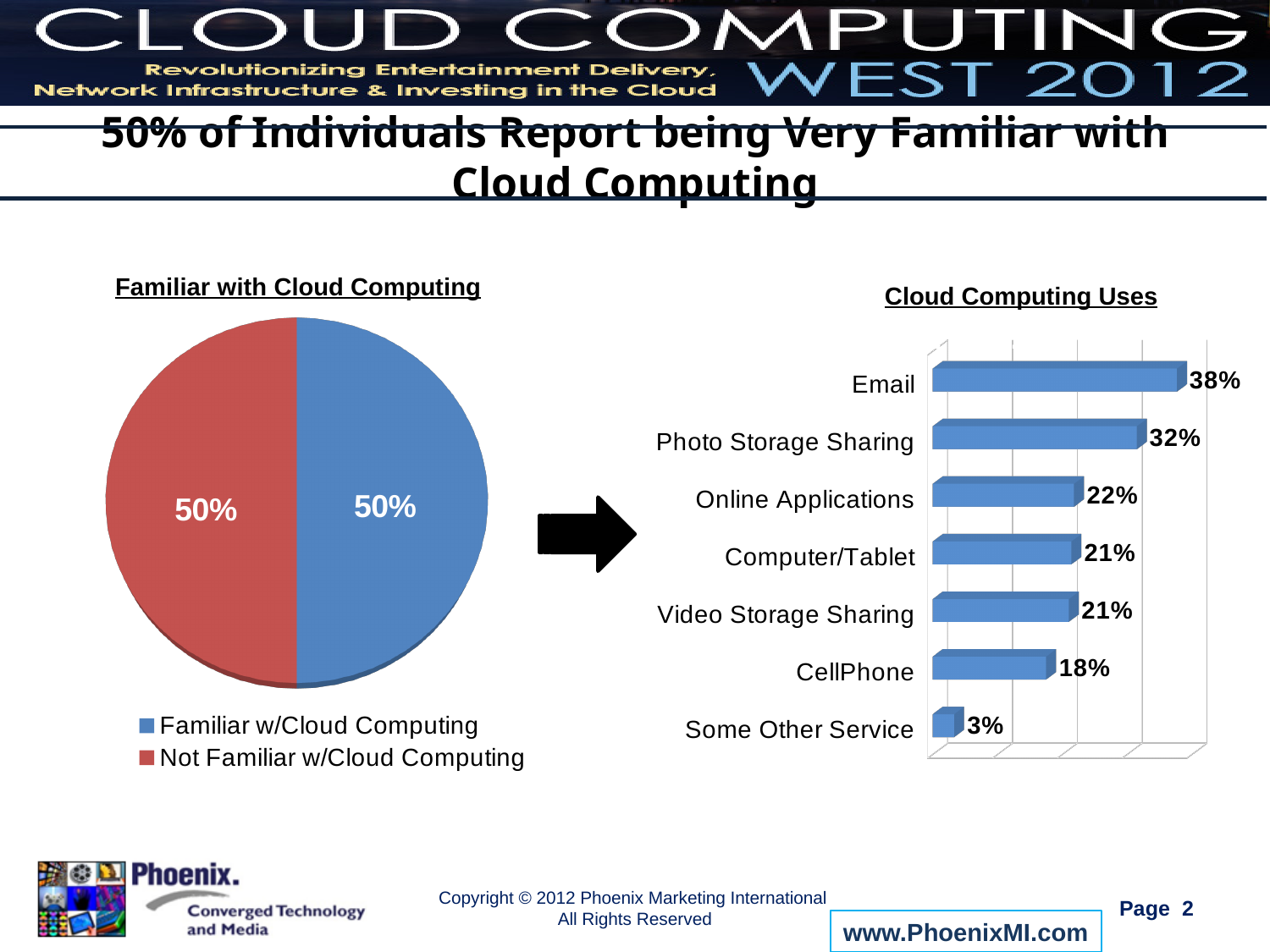
What kind of chart is 'Cloud Computing Uses'? Bar chart In the 'Cloud Computing Uses' chart, which is larger: Online Applications or CellPhone? Online Applications What kind of chart is 'Familiar with Cloud Computing'? Pie chart In the 'Cloud Computing Uses' chart, which category has the highest value? Email In the 'Cloud Computing Uses' chart, what percentage is shown for Photo Storage Sharing? 32% In the 'Familiar with Cloud Computing' chart, what share is labelled for Familiar w/Cloud Computing? 50% In the 'Cloud Computing Uses' chart, what is the difference between Email and Photo Storage Sharing? 6% In the 'Cloud Computing Uses' chart, what percentage is shown for CellPhone? 18% In the 'Cloud Computing Uses' chart, what percentage is shown for Email? 38% In the 'Cloud Computing Uses' chart, which category has the lowest value? Some Other Service How many entries does the legend of the 'Familiar with Cloud Computing' chart list? 2 How many categories are shown in the 'Cloud Computing Uses' chart? 7